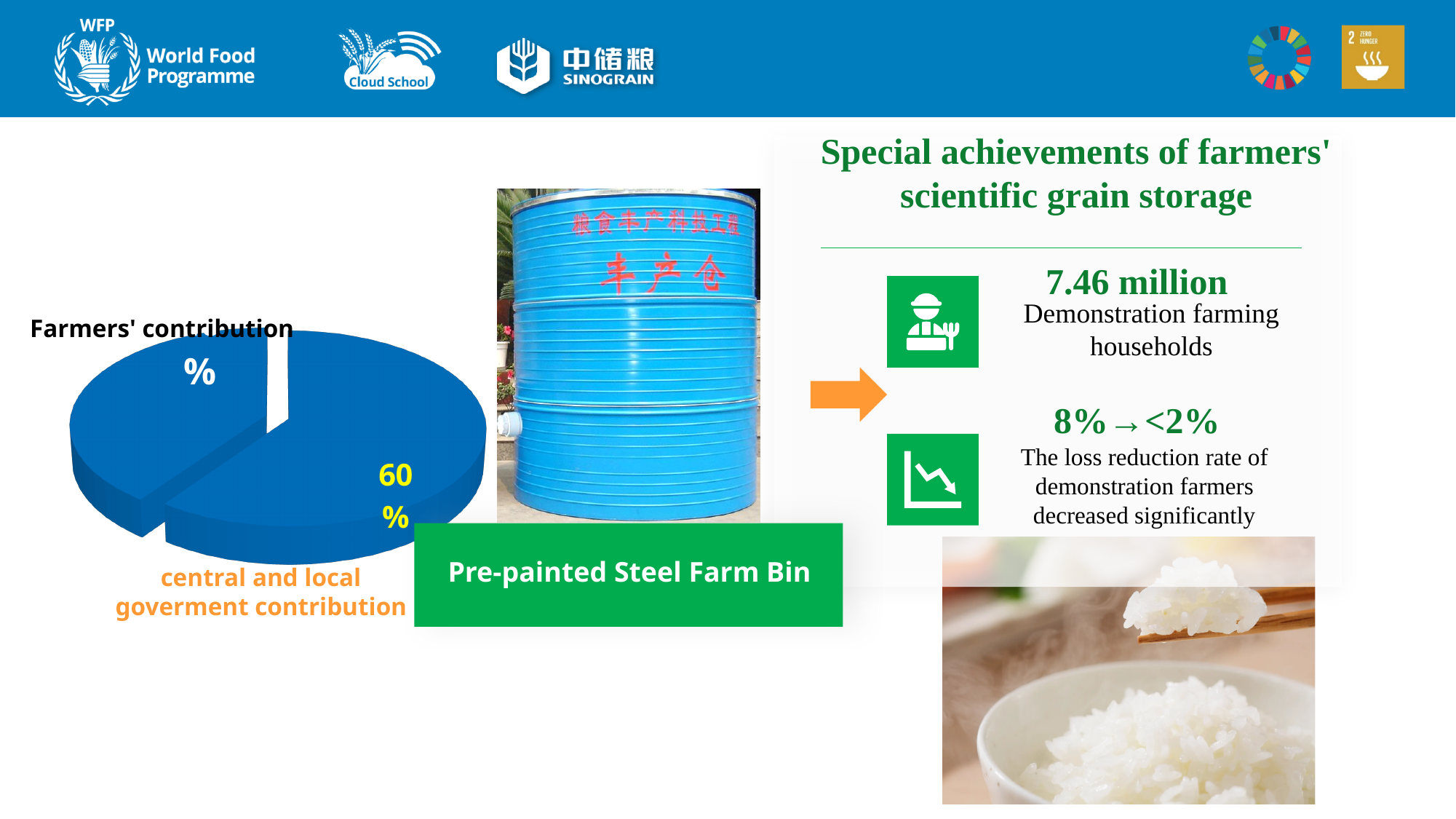
In the pie chart, what value is printed for the central and local goverment contribution? 60% Which slice of the pie chart is the smallest? Farmers' contribution Is the central and local goverment contribution share in the pie chart greater or less than 50%? greater Which slice of the pie chart has its data label printed in yellow? central and local goverment contribution What kind of chart is shown on the left of the slide? Pie chart Which slice of the pie chart is the largest? central and local goverment contribution How many slices does the pie chart on the left have? 2 In the pie chart, which is larger: Farmers' contribution or central and local goverment contribution? central and local goverment contribution What colour are the slices of the pie chart? Blue